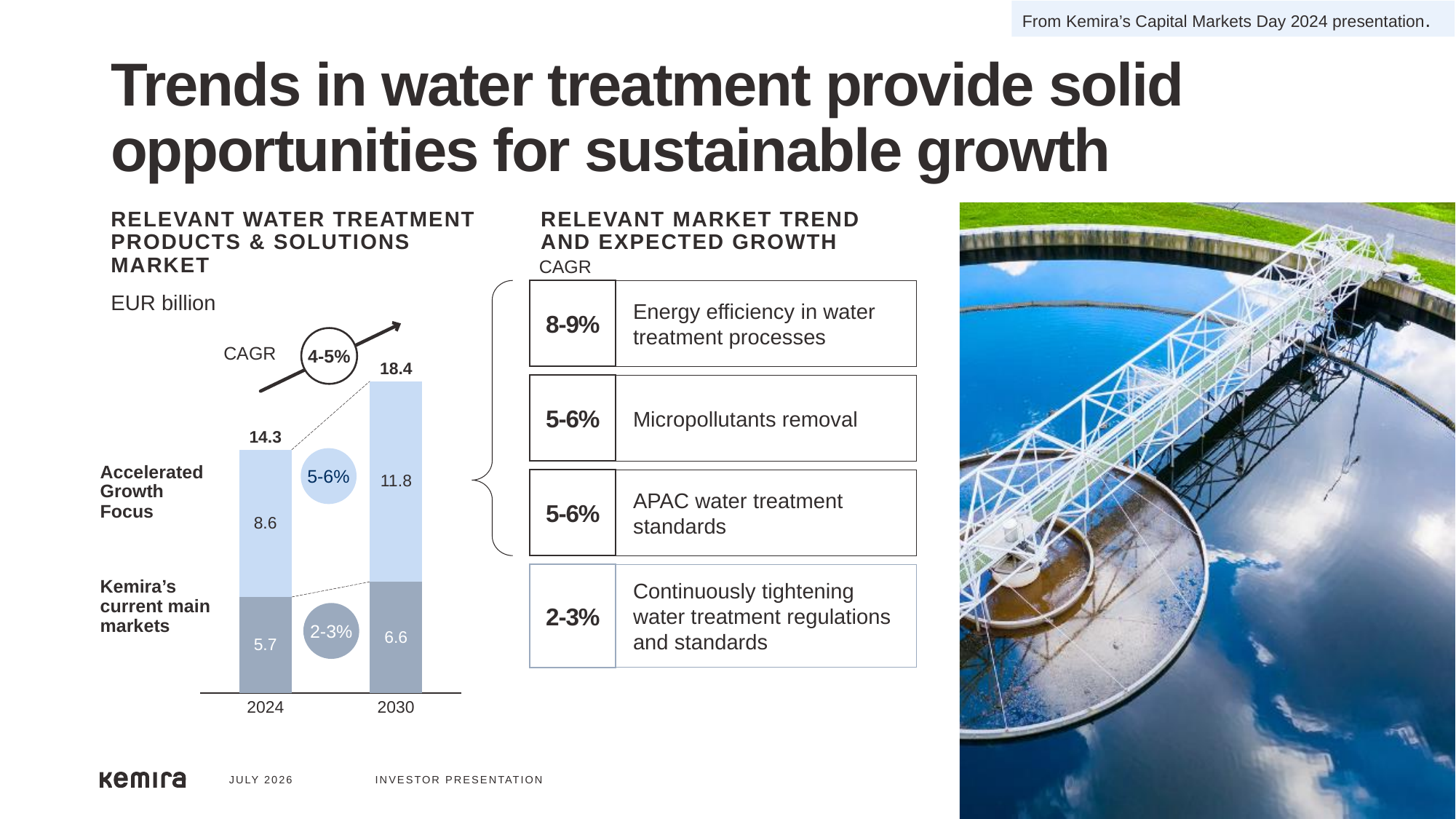
In the stacked bar chart, what is the Kemira's current main markets value for 2030? 6.6 Which year has the larger total in the stacked bar chart, 2024 or 2030? 2030 In the stacked bar chart, what is the Accelerated Growth Focus value for 2024? 8.6 By how much does the total market grow from 2024 to 2030 in the stacked bar chart? 4.1 How many years are shown on the x axis of the stacked bar chart? 2 What is the difference between the Accelerated Growth Focus values for 2030 and 2024 in the stacked bar chart? 3.2 What overall CAGR is shown above the stacked bar chart? 4-5% In the stacked bar chart, what is the Accelerated Growth Focus value for 2030? 11.8 In the stacked bar chart, what is the Kemira's current main markets value for 2024? 5.7 What is the total value of the 2030 bar in the Relevant Water Treatment Products & Solutions Market chart? 18.4 What is the total value of the 2024 bar in the Relevant Water Treatment Products & Solutions Market chart? 14.3 What type of chart is shown under the Relevant Water Treatment Products & Solutions Market heading? Stacked bar chart